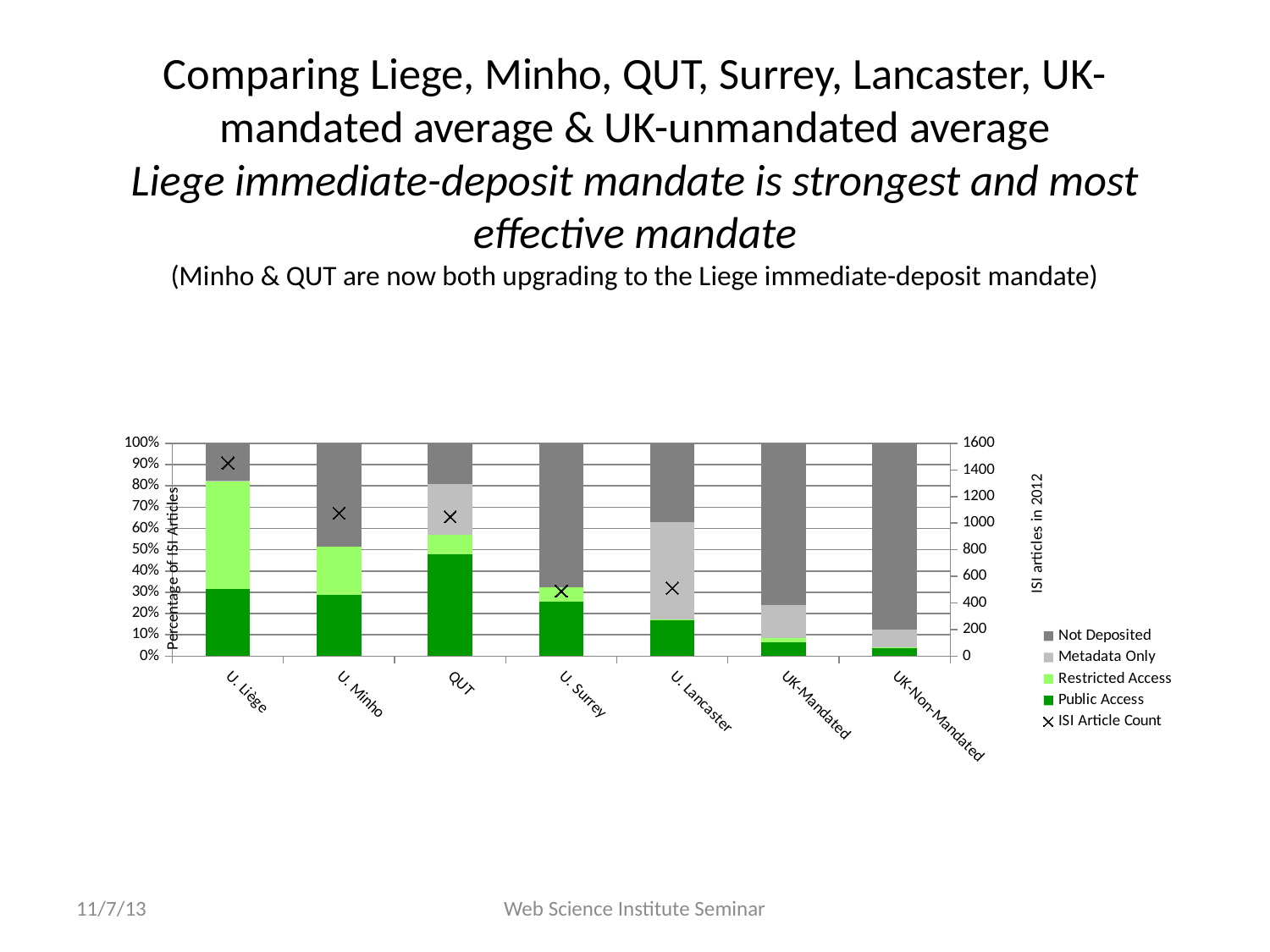
Which has the larger Public Access share, QUT or U. Surrey? QUT How many entries does the chart's legend list? 5 Which category has the largest Not Deposited share? UK-Non-Mandated What is the title of the right-hand vertical axis? ISI articles in 2012 Which category has the largest Restricted Access share? U. Liège Is the Public Access share for UK-Mandated greater or less than 10%? less Which category has the largest Public Access share? QUT What kind of chart is shown on the slide? Stacked bar chart Which category has the smallest Public Access share? UK-Non-Mandated Is the Public Access share for QUT greater or less than 40%? greater How many categories are shown along the x axis of the chart? 7